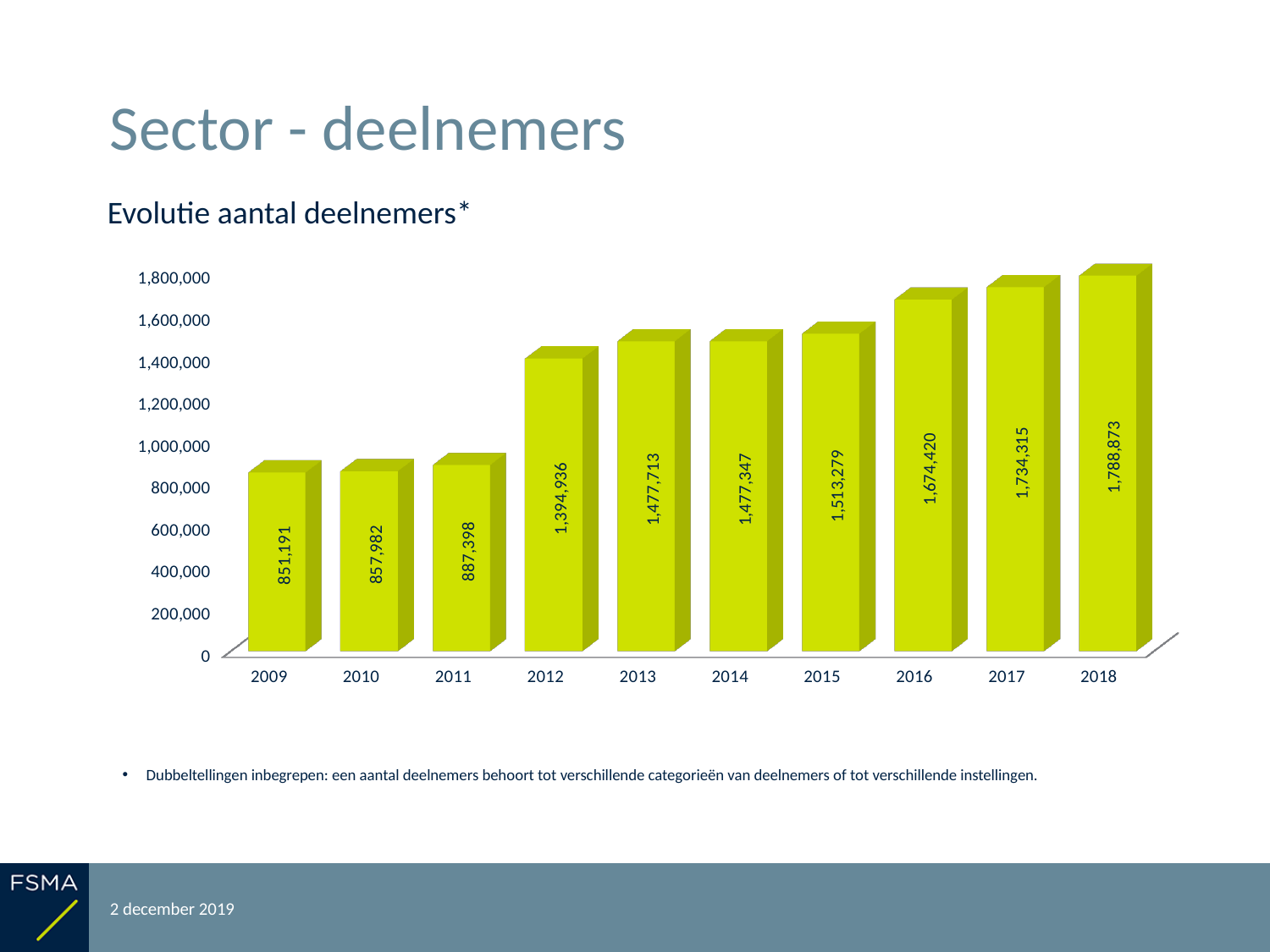
Which is larger, the value for 2015 or the value for 2016? 2016 How many years are shown on the x axis? 10 What is the difference between the values for 2012 and 2011? 507,538 What is the value for 2012? 1,394,936 Do the values generally rise or fall from 2009 to 2018? Rise Which year has the lowest value? 2009 What type of chart is shown on the slide? Bar chart Which year has the highest value? 2018 What is the difference between the values for 2018 and 2009? 937,682 What is the value for 2016? 1,674,420 What is the value for 2018? 1,788,873 What is the value for 2009? 851,191